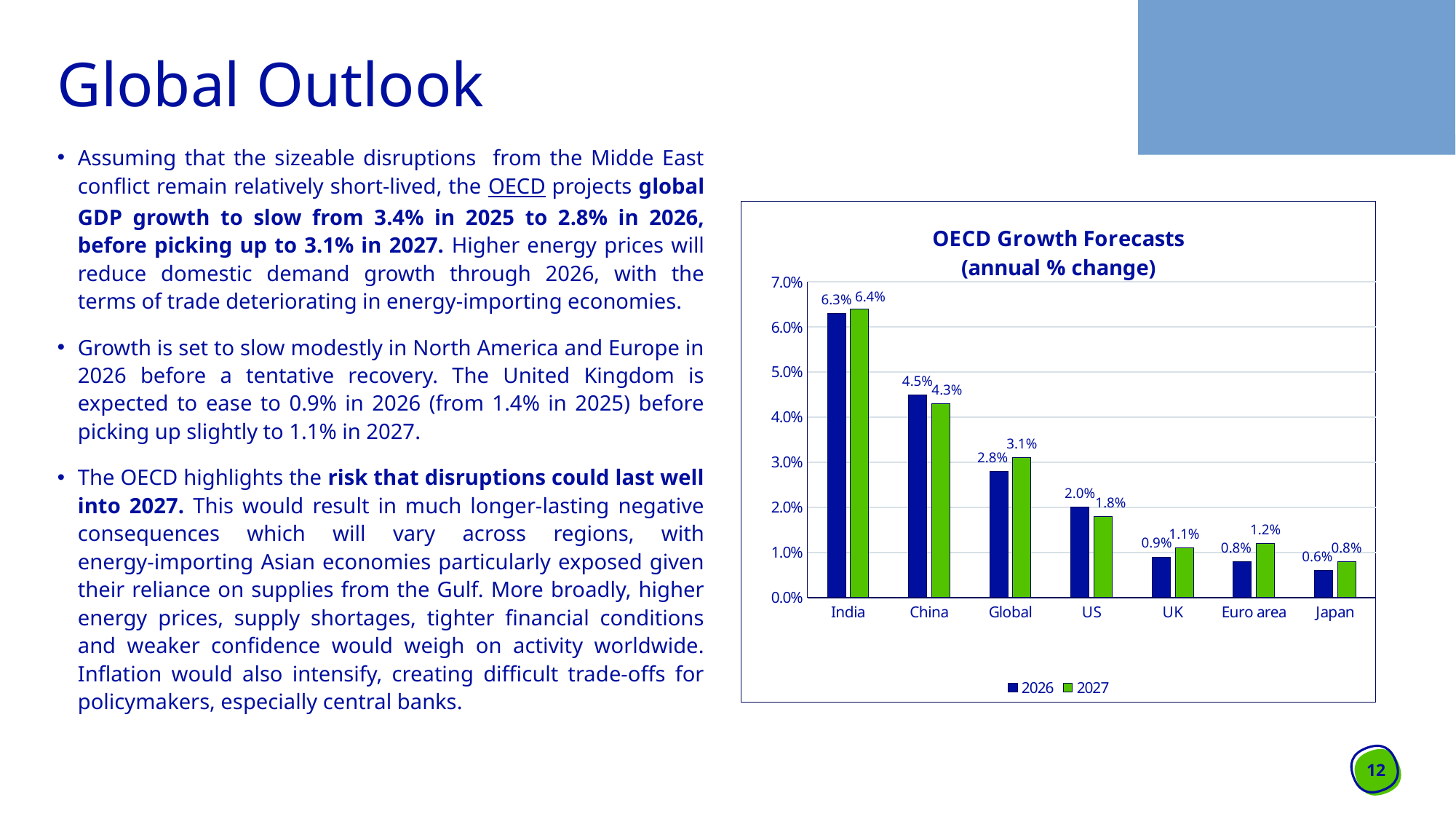
What is the difference between China's 2026 and 2027 growth forecasts? 0.2% How many categories are shown on the x axis of the chart? 7 What is the 2026 growth forecast for the UK? 0.9% What kind of chart is shown on the slide? Bar chart How many series does the legend list? 2 Which category has the lowest 2026 growth forecast? Japan Which is larger for the US: the 2026 forecast or the 2027 forecast? 2026 Is the 2027 growth forecast for Global greater or less than 3.0%? greater What is the title of the chart? OECD Growth Forecasts (annual % change) What is the 2026 growth forecast for India? 6.3% Which category has the highest 2027 growth forecast? India What is the 2027 growth forecast for the Euro area? 1.2%